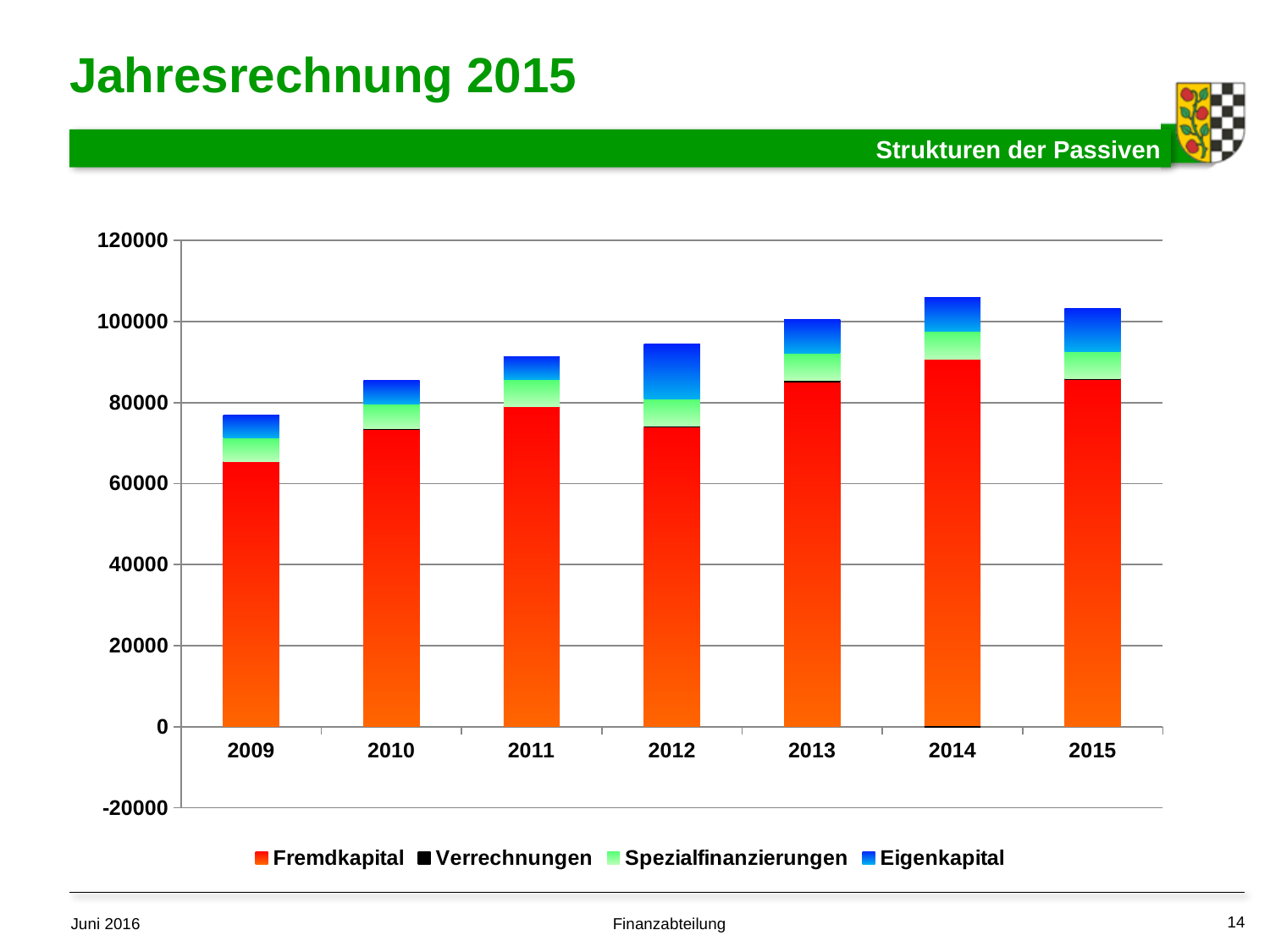
Is the total height of the 2009 bar greater or less than 80000? less Which year has the shortest stacked bar overall? 2009 How many series does the chart legend list? 4 How many years are shown on the x axis of the chart? 7 Is the Fremdkapital value for 2010 greater or less than 80000? less Which year has the larger total bar, 2012 or 2013? 2013 Which series is shown in red in the chart? Fremdkapital Is the total height of the 2014 bar greater or less than 100000? greater Which year has the tallest stacked bar overall? 2014 What kind of chart is shown on the slide? stacked bar chart Does the total bar height rise or fall from 2009 to 2011? rise